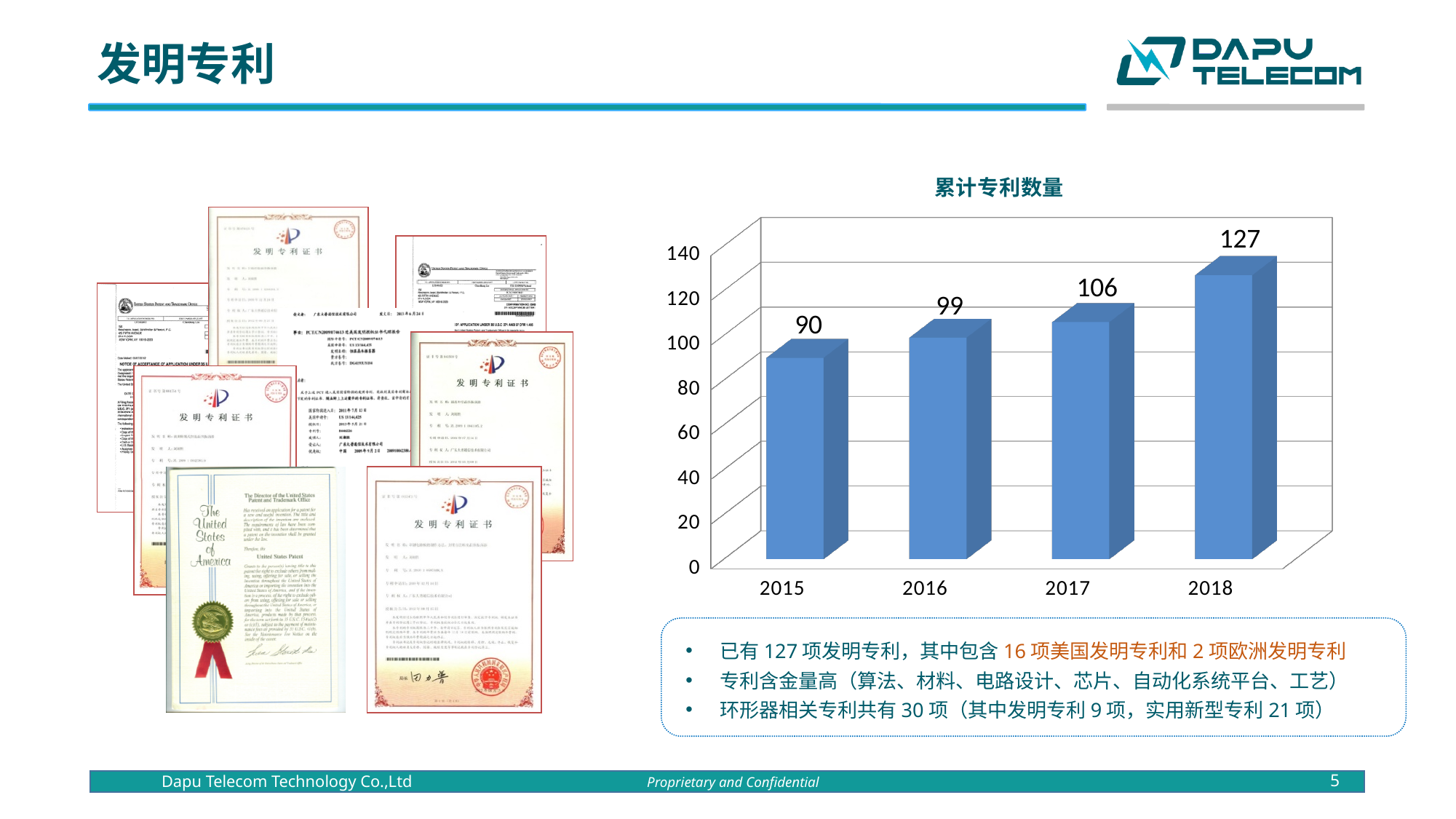
What is the cumulative patent count shown for 2017? 106 Which is larger, the value for 2016 or the value for 2017? 2017 Which year has the highest cumulative patent count? 2018 What is the cumulative patent count shown for 2018? 127 How many years are shown on the x axis of the chart? 4 What is the difference between the 2018 and 2017 values? 21 Which year has the lowest cumulative patent count? 2015 What is the cumulative patent count shown for 2015? 90 What kind of chart is used to show the cumulative patent count? bar chart What is the difference between the 2016 and 2015 values? 9 Is the value for 2018 greater or less than 120? greater Do the values rise or fall from 2015 to 2018? rise